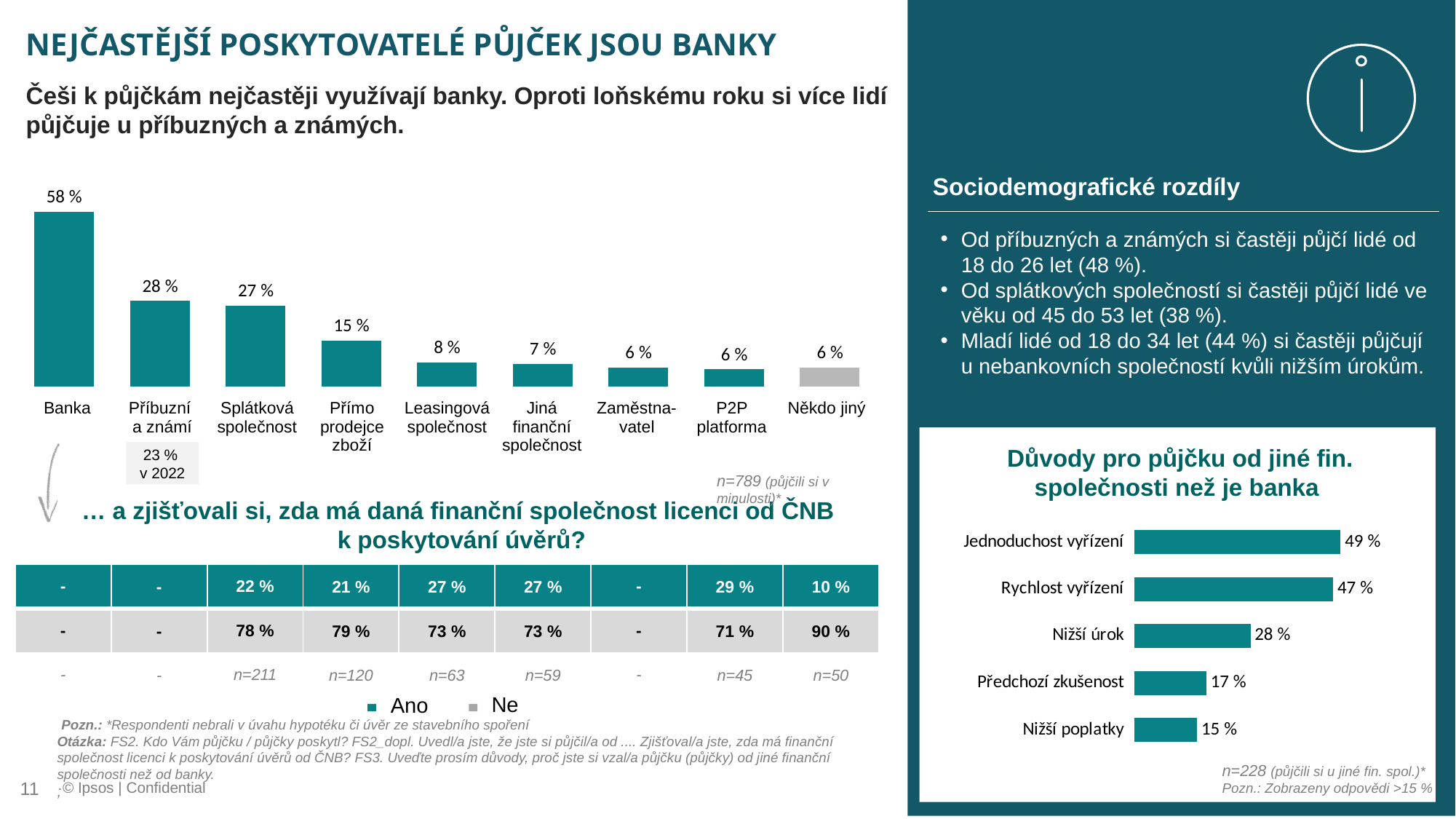
In the chart 'Důvody pro půjčku od jiné fin. společnosti než je banka', what is the difference between Jednoduchost vyřízení and Rychlost vyřízení? 2 % In the left bar chart of loan providers, what is the value for Přímo prodejce zboží? 15 % What kind of chart is 'Důvody pro půjčku od jiné fin. společnosti než je banka'? bar chart In the chart 'Důvody pro půjčku od jiné fin. společnosti než je banka', what is the value for Nižší úrok? 28 % How many categories are shown in the chart 'Důvody pro půjčku od jiné fin. společnosti než je banka'? 5 In the left bar chart of loan providers, do the values rise or fall from left to right? fall In the left bar chart of loan providers, which category has the highest value? Banka In the left bar chart of loan providers, which is larger: Splátková společnost or Leasingová společnost? Splátková společnost In the left bar chart of loan providers, what is the difference between Banka and Příbuzní a známí? 30 % In the chart 'Důvody pro půjčku od jiné fin. společnosti než je banka', which category has the lowest value? Nižší poplatky How many categories are shown in the left bar chart of loan providers? 9 In the left bar chart of loan providers, what is the value for Banka? 58 %